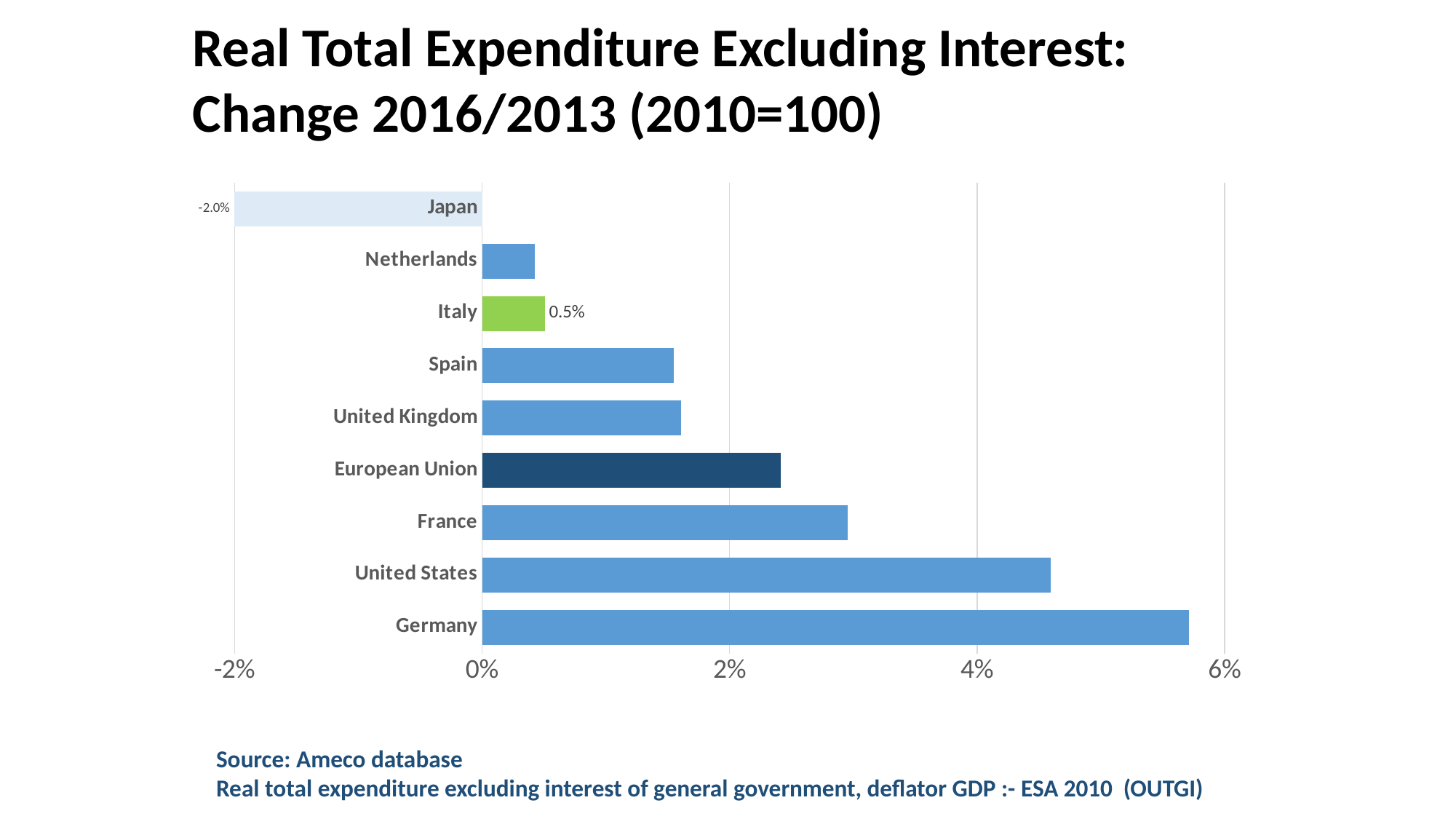
Which has the larger value, France or Spain? France Is the value for the United States greater or less than 4%? greater How many countries or regions are shown in the chart? 9 Which country has the highest value in the chart? Germany Which has the larger value, Germany or the United States? Germany What is the difference between the values for Italy and Japan? 2.5 percentage points Which country has the lowest value in the chart? Japan What kind of chart is shown on the slide? Bar chart What is the value shown for Japan? -2.0% Is the value for Spain greater or less than 2%? less What is the value shown for Italy? 0.5% Is the value for the European Union greater or less than 2%? greater